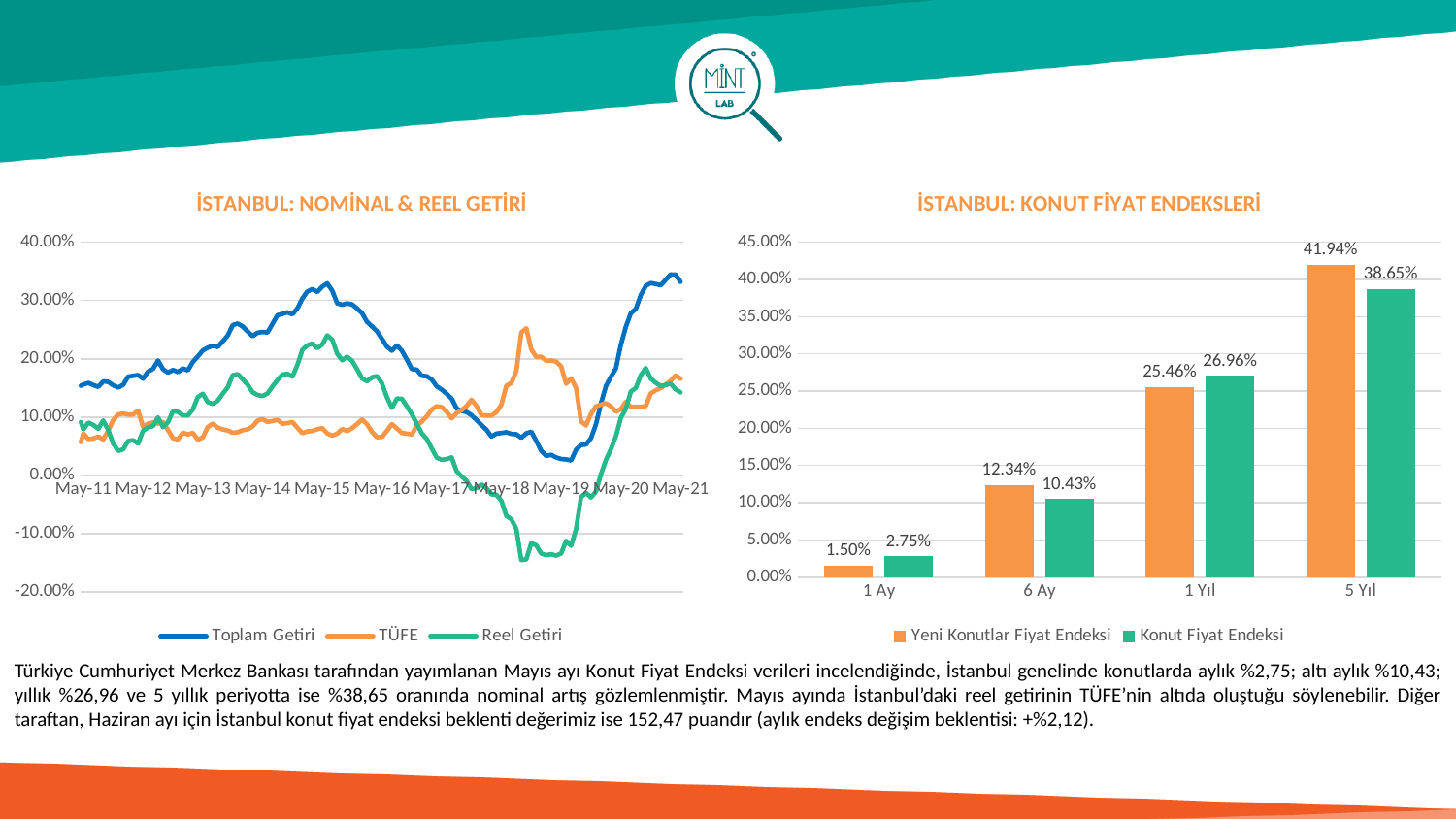
In the 'İSTANBUL: KONUT FİYAT ENDEKSLERİ' chart, what is the value of Konut Fiyat Endeksi for 6 Ay? 10.43% In the 'İSTANBUL: KONUT FİYAT ENDEKSLERİ' chart, how many categories are shown on the x axis? 4 In the 'İSTANBUL: KONUT FİYAT ENDEKSLERİ' chart, which category has the lowest value for Konut Fiyat Endeksi? 1 Ay In the 'İSTANBUL: KONUT FİYAT ENDEKSLERİ' chart, what is the value of Konut Fiyat Endeksi for 1 Ay? 2.75% What kind of chart is 'İSTANBUL: NOMİNAL & REEL GETİRİ'? Line chart What kind of chart is 'İSTANBUL: KONUT FİYAT ENDEKSLERİ'? Bar chart In the 'İSTANBUL: KONUT FİYAT ENDEKSLERİ' chart, what is the difference between Yeni Konutlar Fiyat Endeksi and Konut Fiyat Endeksi for 5 Yıl? 3.29% In the 'İSTANBUL: KONUT FİYAT ENDEKSLERİ' chart, how many series does the legend list? 2 How many series does the legend of the 'İSTANBUL: NOMİNAL & REEL GETİRİ' chart list? 3 In the 'İSTANBUL: KONUT FİYAT ENDEKSLERİ' chart, which category has the highest value for Yeni Konutlar Fiyat Endeksi? 5 Yıl In the 'İSTANBUL: KONUT FİYAT ENDEKSLERİ' chart, what is the value of Yeni Konutlar Fiyat Endeksi for 5 Yıl? 41.94% In the 'İSTANBUL: KONUT FİYAT ENDEKSLERİ' chart, which is larger for 1 Yıl: Yeni Konutlar Fiyat Endeksi or Konut Fiyat Endeksi? Konut Fiyat Endeksi